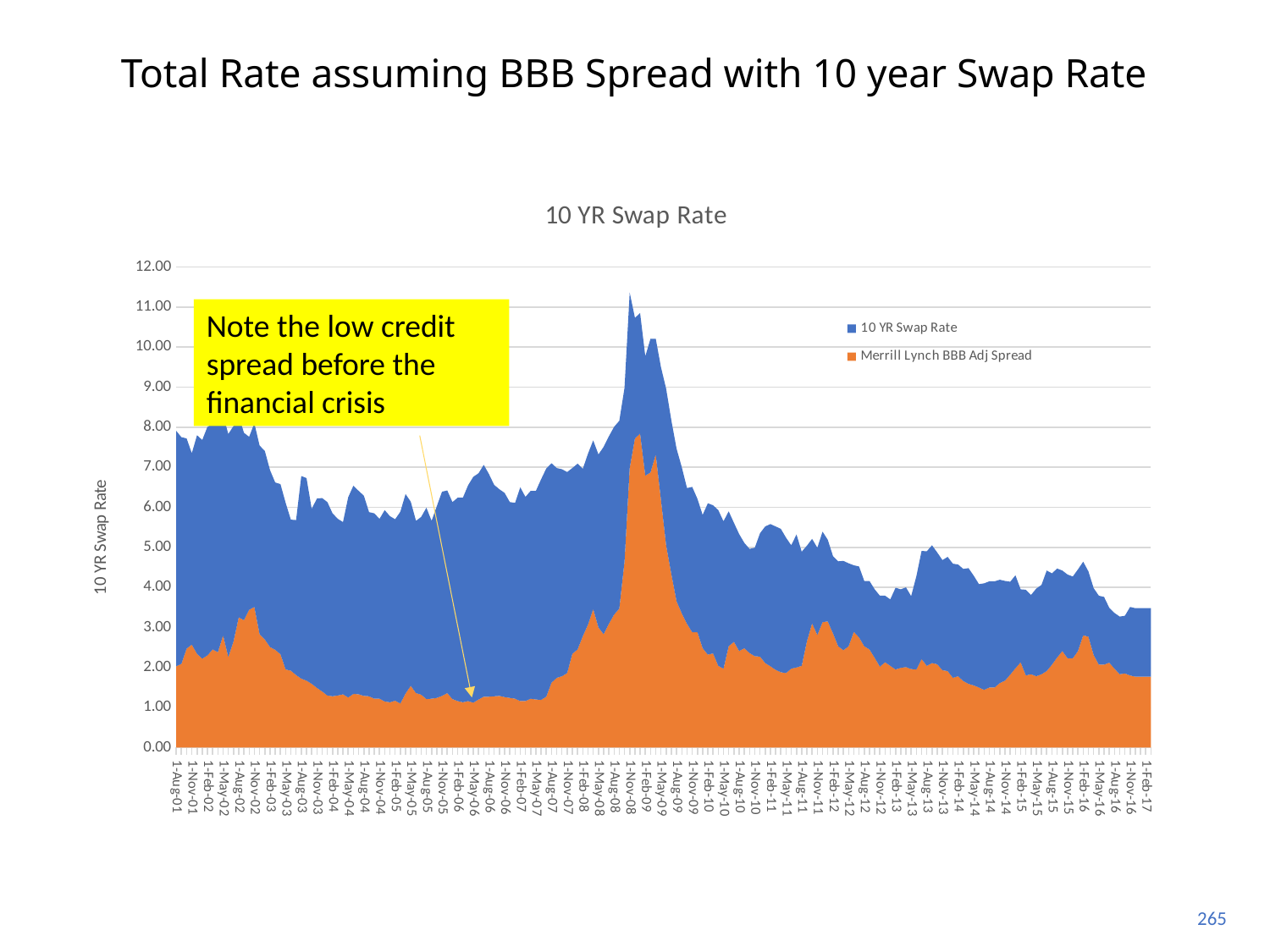
Does the stacked total rise or fall between 1-Feb-09 and 1-Aug-09? Fall What are the two series named in the chart's legend? 10 YR Swap Rate and Merrill Lynch BBB Adj Spread In which year does the stacked total reach its highest point? 2008 Which is larger: the stacked total at 1-Nov-08 or the stacked total at 1-Feb-17? 1-Nov-08 Does the Merrill Lynch BBB Adj Spread rise or fall between 1-Aug-07 and 1-Nov-08? Rise Is the stacked total at 1-Feb-17 greater or less than 4.00? less What colour represents the Merrill Lynch BBB Adj Spread series? Orange What kind of chart is shown on the slide? Stacked area chart Is the Merrill Lynch BBB Adj Spread value at 1-May-06 greater or less than 2.00? less How many series does the chart's legend list? 2 Is the stacked total at 1-Nov-08 greater or less than 10.00? greater